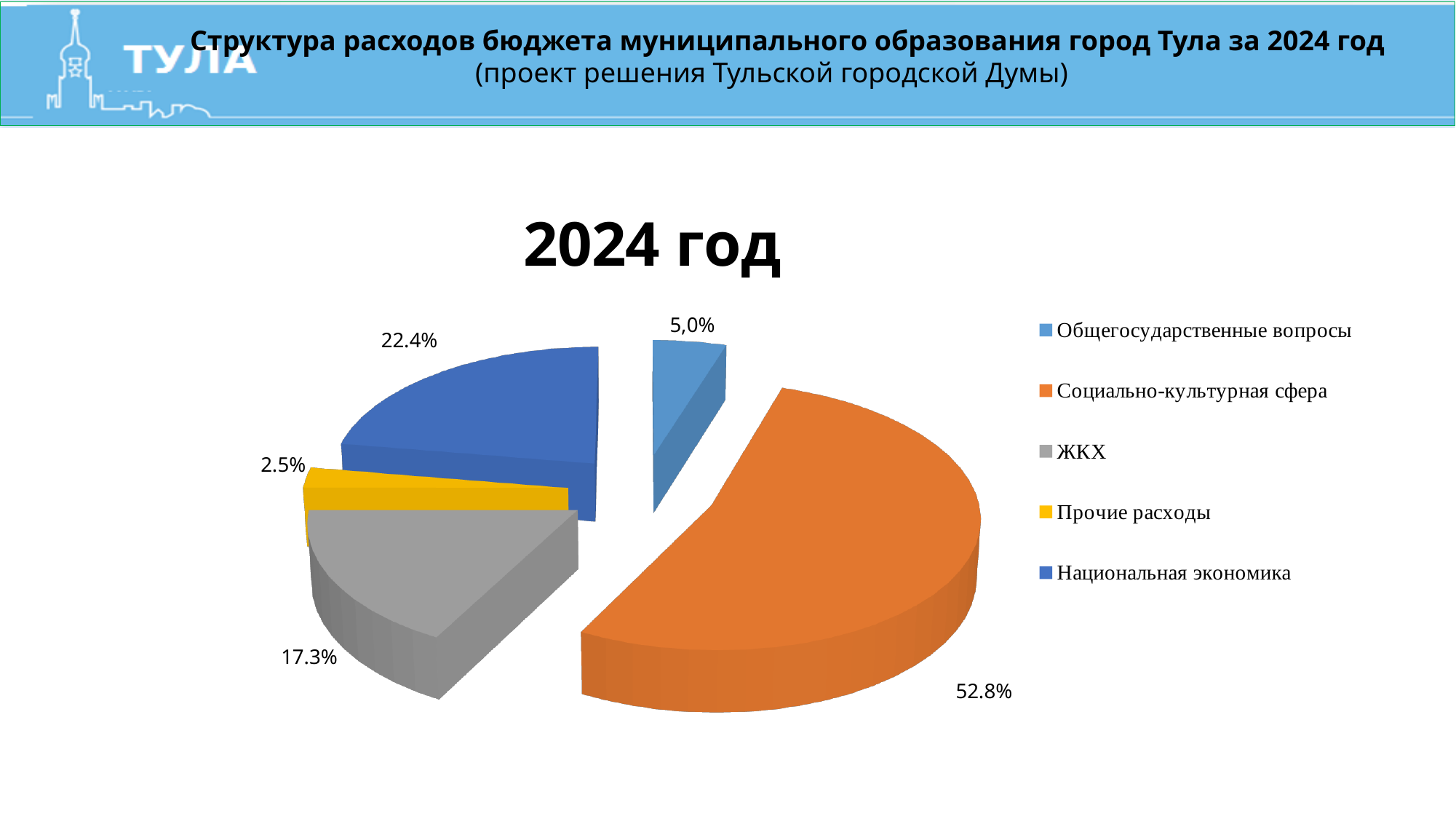
Which category has the smallest share of the pie? Прочие расходы What type of chart is shown on the slide? Pie chart What is the share for Социально-культурная сфера? 52.8% Which category has the largest share of the pie? Социально-культурная сфера How many categories does the legend list? 5 What is the share for ЖКХ? 17.3% What is the share for Прочие расходы? 2.5% What is the share for Общегосударственные вопросы? 5,0% Which is larger: the share for Национальная экономика or the share for ЖКХ? Национальная экономика What is the difference in percentage points between the shares for Национальная экономика and ЖКХ? 5.1 What is the title of the chart? 2024 год What is the share for Национальная экономика? 22.4%